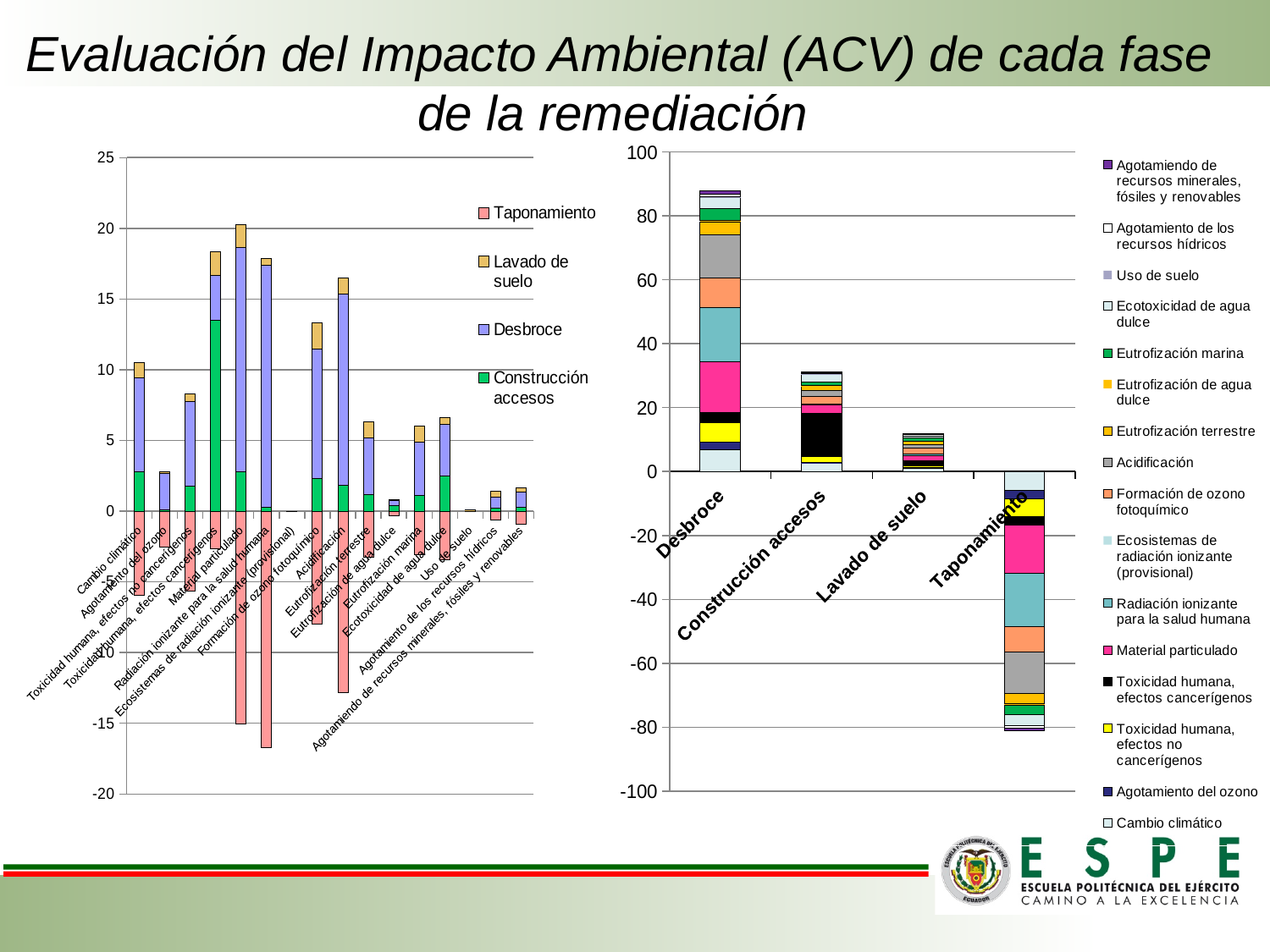
How many series does the legend of the chart on the right list? 16 In the chart on the right, which category is the only one with a negative stacked bar? Taponamiento What kind of chart is the chart on the right of the slide? stacked bar chart In the chart on the right, is the total for Taponamiento greater or less than -60? less In the chart on the right, is the total for Lavado de suelo greater or less than 20? less In the chart on the right, which category has the tallest positive stacked bar? Desbroce How many categories are shown on the x axis of the chart on the right? 4 In the chart on the right, which has the larger positive total, Desbroce or Construcción accesos? Desbroce In the chart on the right, is the total for Construcción accesos greater or less than 40? less How many series does the legend of the chart on the left list? 4 In the chart on the left, which series is plotted with the bars that extend below zero? Taponamiento